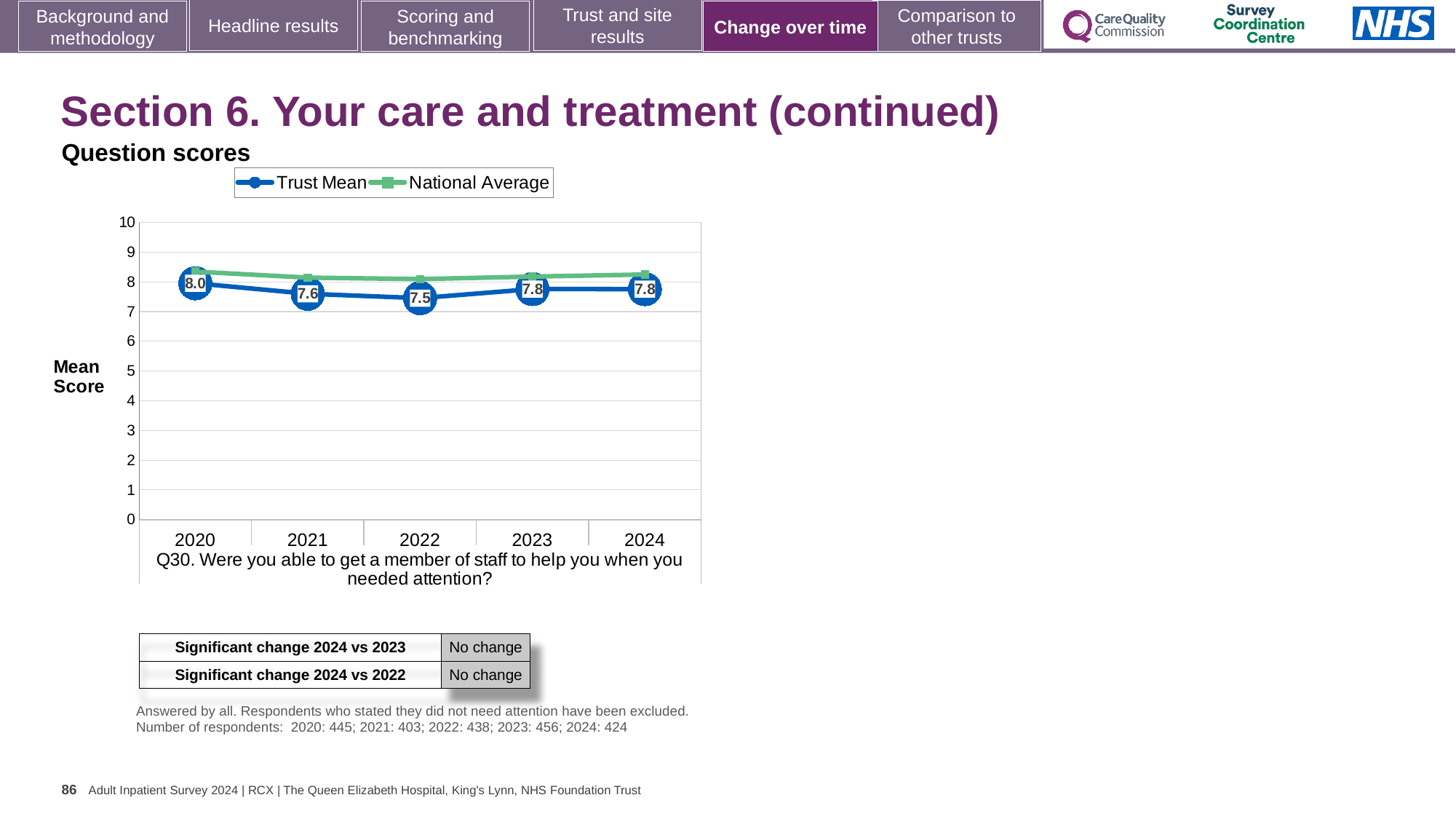
What kind of chart is shown on the slide? Line chart Which is larger, the Trust Mean score in 2021 or in 2022? 2021 What is the Trust Mean score for 2022? 7.5 What is the Trust Mean score for 2024? 7.8 In which year is the Trust Mean score lowest? 2022 What is the Trust Mean score for 2020? 8.0 In which year is the Trust Mean score highest? 2020 How many series does the legend list? 2 How many years are shown on the x axis? 5 In 2022, which series has the higher value, Trust Mean or National Average? National Average What is the difference between the Trust Mean score in 2020 and in 2022? 0.5 Is the National Average value for 2020 greater or less than 8? greater